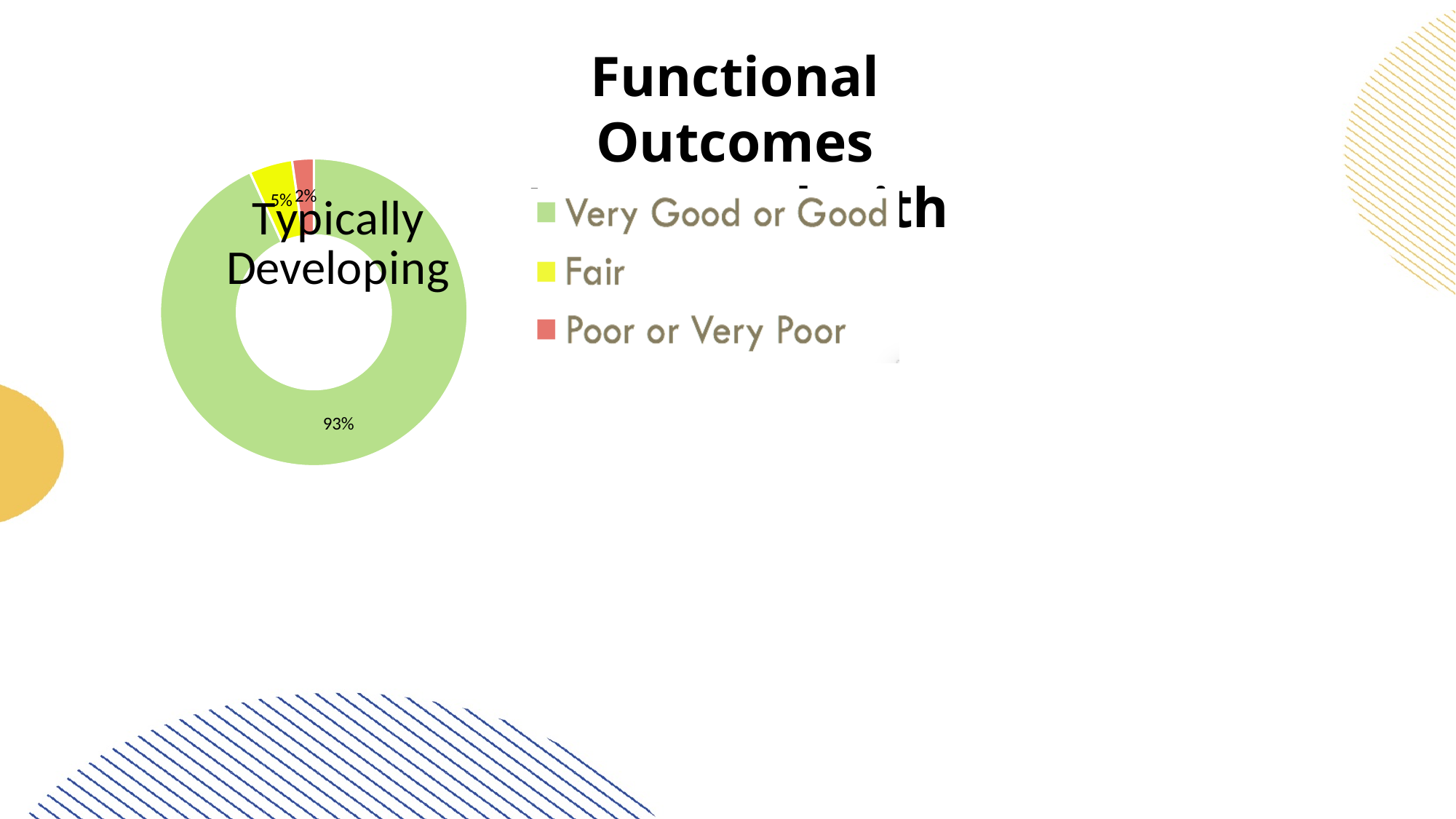
How many entries does the legend list? 3 What share of the Typically Developing chart is Very Good or Good? 93% What kind of chart is shown on the slide? doughnut chart What colour represents Fair in the chart? yellow What label appears in the centre of the doughnut chart? Typically Developing What is the difference in percentage points between the Very Good or Good slice and the Fair slice? 88 Which category has the smallest slice in the Typically Developing chart? Poor or Very Poor What share of the Typically Developing chart is Poor or Very Poor? 2% How many slices does the Typically Developing chart have? 3 What share of the Typically Developing chart is Fair? 5% Which category has the largest slice in the Typically Developing chart? Very Good or Good Which is larger, the Fair slice or the Poor or Very Poor slice? Fair